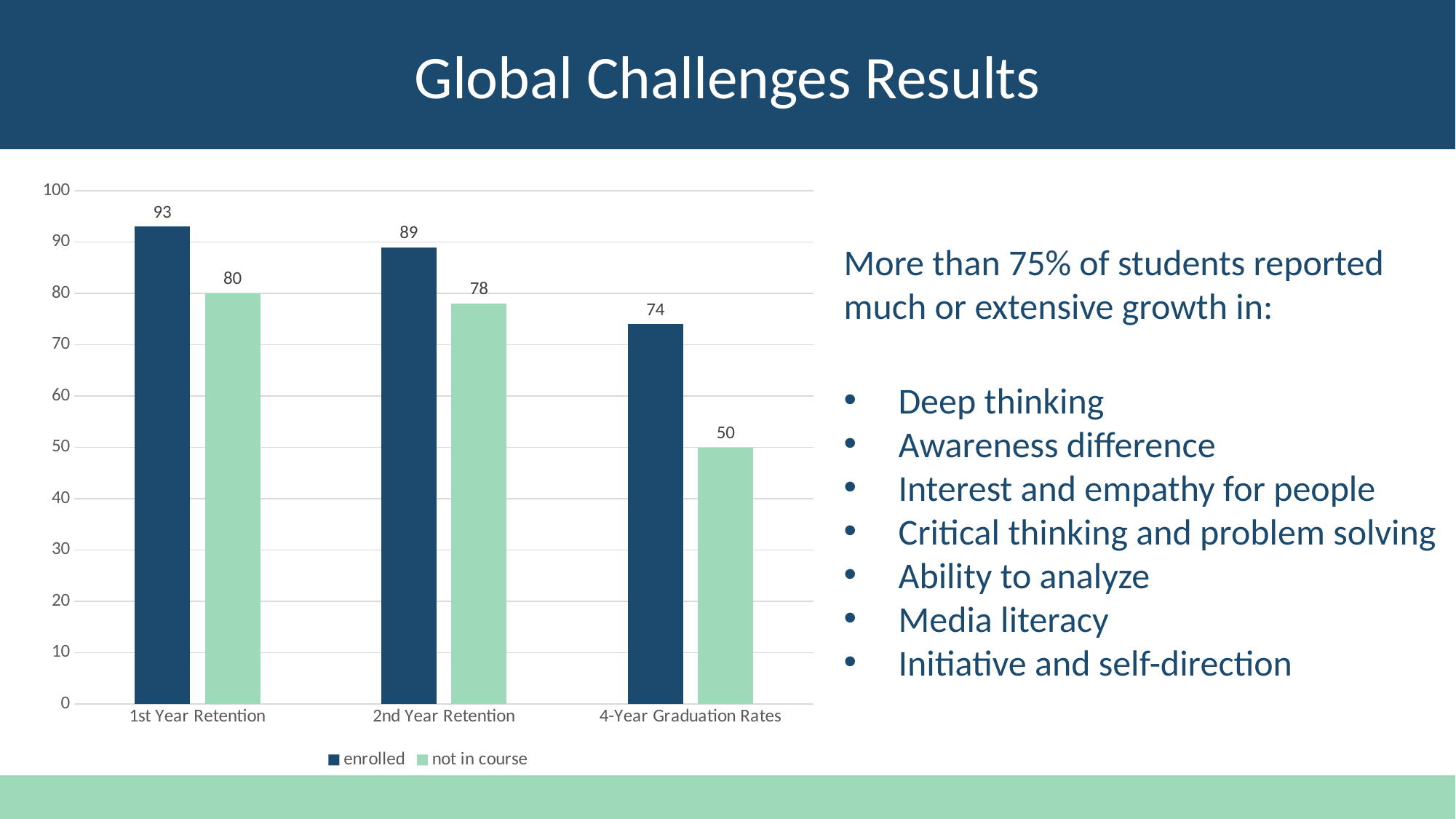
What is the difference between the enrolled values for 1st Year Retention and 2nd Year Retention? 4 What kind of chart is shown on the slide? bar chart What is the value for enrolled students in 1st Year Retention? 93 Which is larger: the enrolled value for 2nd Year Retention or the not in course value for 1st Year Retention? enrolled value for 2nd Year Retention Do the enrolled values rise or fall from 1st Year Retention to 4-Year Graduation Rates? fall Which category has the lowest value for the not in course series? 4-Year Graduation Rates Which category has the highest value for the enrolled series? 1st Year Retention What is the value for students not in course in 4-Year Graduation Rates? 50 What is the value for students not in course in 2nd Year Retention? 78 What is the difference between enrolled and not in course values for 4-Year Graduation Rates? 24 How many series does the chart legend list? 2 How many categories are shown on the x axis of the chart? 3